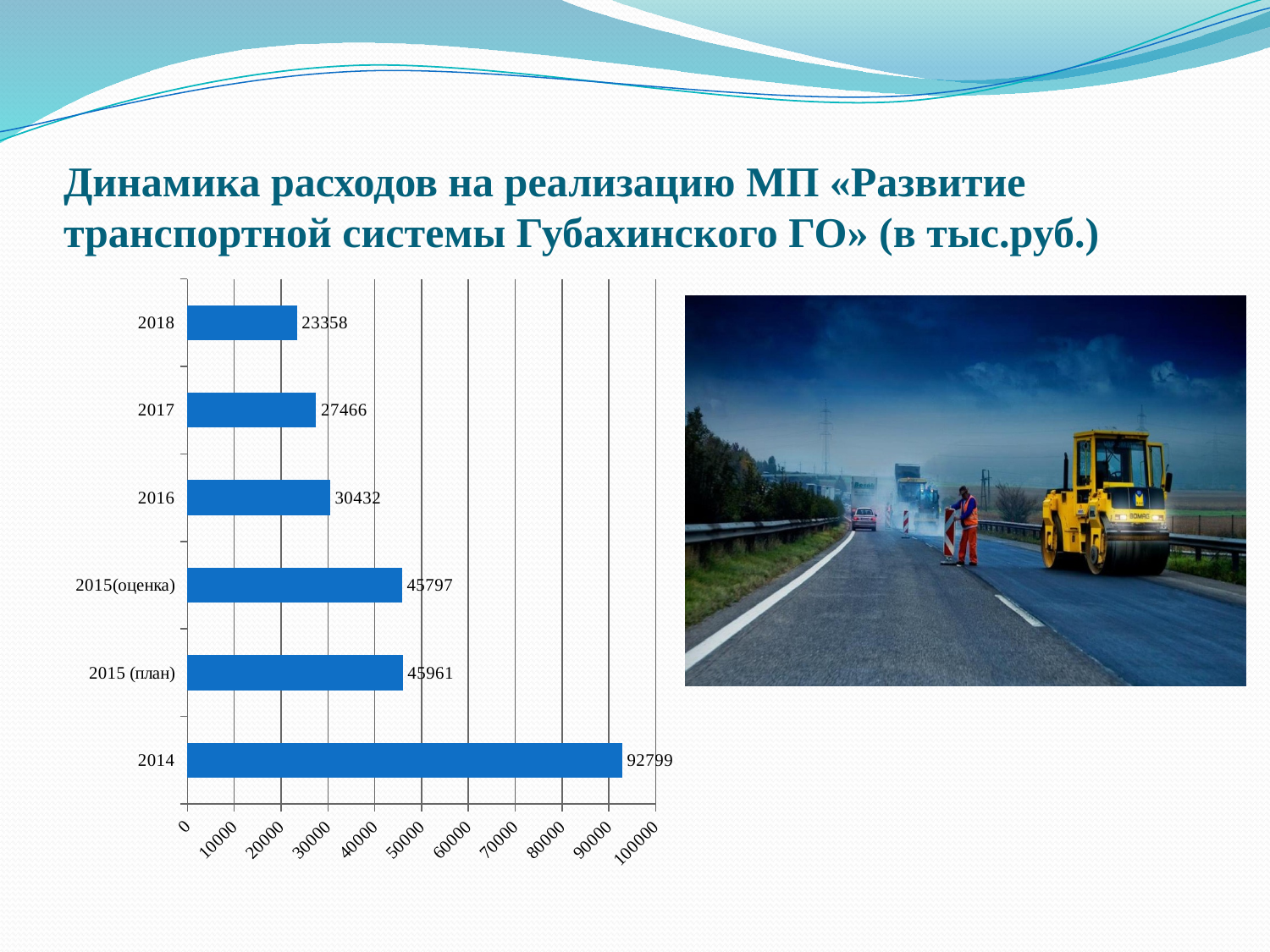
What is the value for 2016? 30432 Which category has the highest value? 2014 Which is larger, the value for 2015 (план) or the value for 2015(оценка)? 2015 (план) What is the difference between the values for 2014 and 2018? 69441 How many categories are shown in the chart? 6 Which category has the lowest value? 2018 What is the value for 2018? 23358 What is the difference between the values for 2017 and 2016? 2966 What kind of chart is shown on the slide? bar chart Do the values rise or fall from 2016 to 2018? fall What is the value for 2014? 92799 What is the value for 2015 (план)? 45961